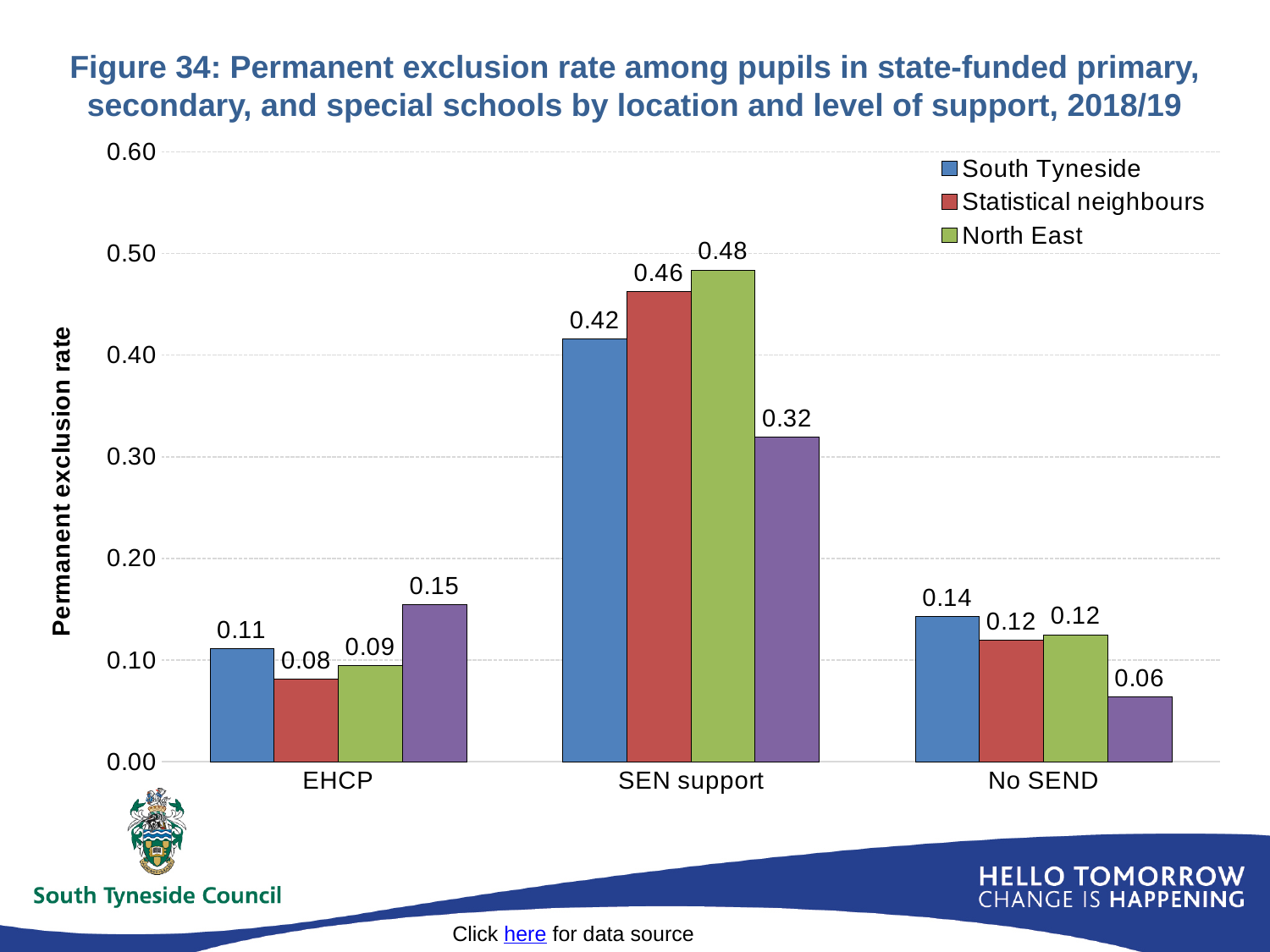
For SEN support, how much higher is the Statistical neighbours rate than the South Tyneside rate? 0.04 What kind of chart is shown on the slide? Bar chart What is the permanent exclusion rate for South Tyneside in the EHCP category? 0.11 How many series does the legend list? 3 Is the North East value for SEN support greater or less than 0.40? greater What is the title of the vertical axis? Permanent exclusion rate For the EHCP category, which is larger: the South Tyneside rate or the North East rate? South Tyneside What is the permanent exclusion rate for North East in the SEN support category? 0.48 In which level-of-support category is the South Tyneside permanent exclusion rate highest? SEN support In which level-of-support category is the Statistical neighbours permanent exclusion rate lowest? EHCP What is the permanent exclusion rate for Statistical neighbours in the No SEND category? 0.12 How many level-of-support categories are shown on the x axis? 3